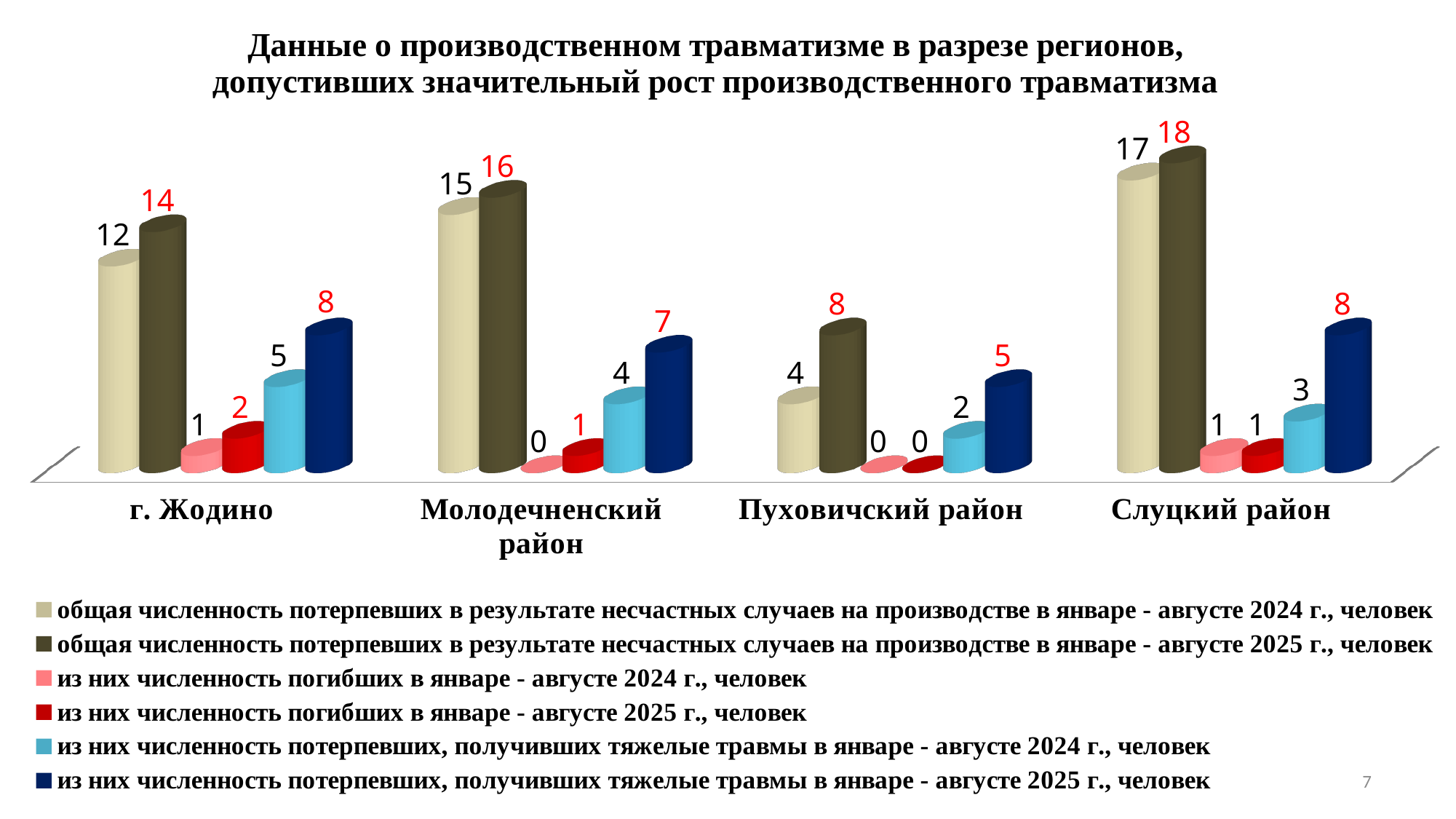
What kind of chart is shown on the slide? Bar chart How many regions are shown on the chart? 4 What is the total number of injured persons in January–August 2024 for г. Жодино? 12 How many fatalities were recorded in January–August 2025 for г. Жодино? 2 Which is larger for Молодечненский район: severe injuries in January–August 2024 or in January–August 2025? January–August 2025 What is the total number of injured persons in January–August 2025 for Слуцкий район? 18 What is the difference between the total number of injured persons in January–August 2025 and January–August 2024 for Пуховичский район? 4 How many series does the legend list? 6 How many persons received severe injuries in January–August 2025 in Молодечненский район? 7 Which region has the lowest total number of injured persons in January–August 2024? Пуховичский район Which region has the highest total number of injured persons in January–August 2025? Слуцкий район What colour are the bars for the total number of injured persons in January–August 2025? Dark brown